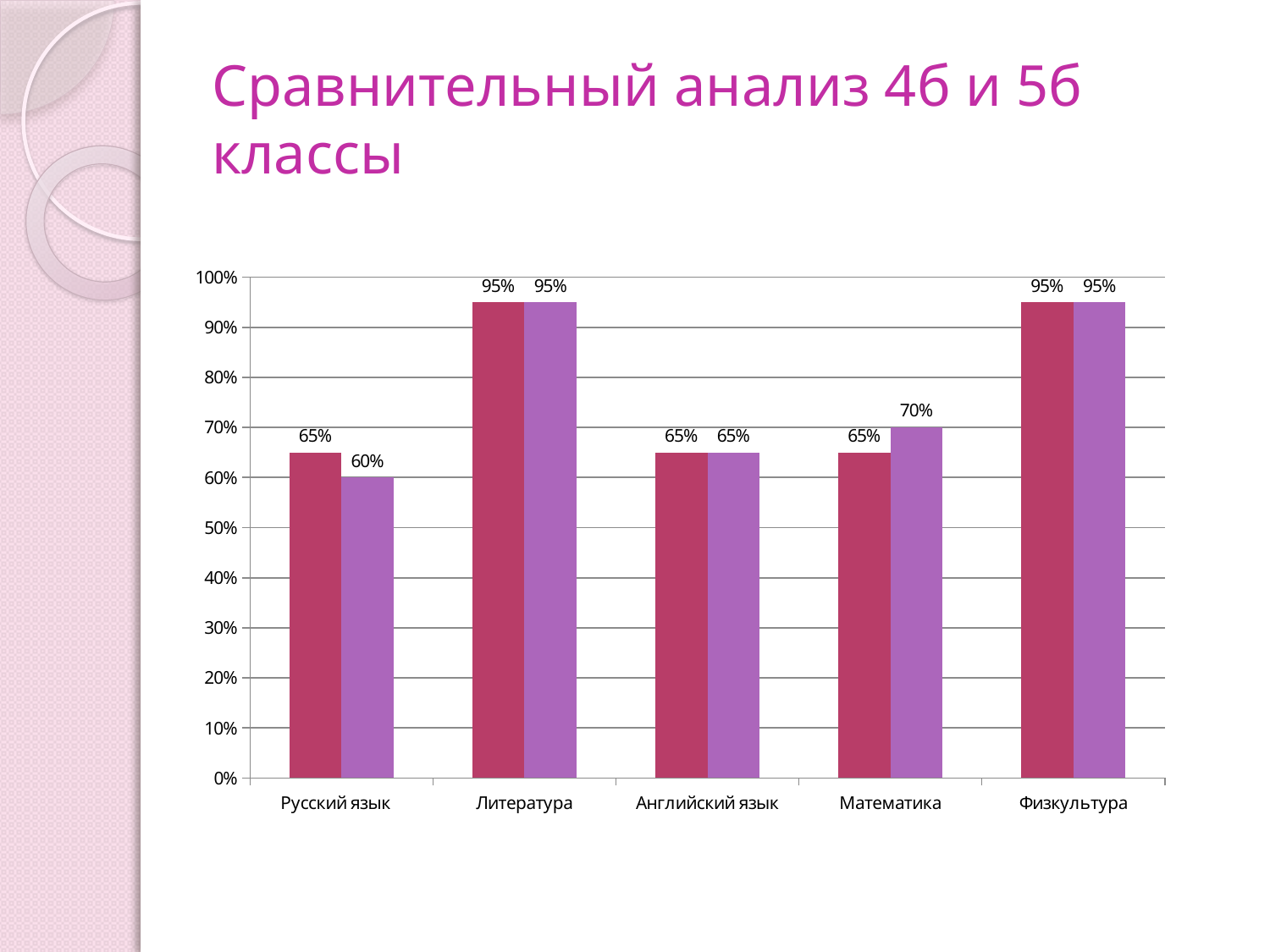
What is the title of the slide containing the chart? Сравнительный анализ 4б и 5б классы What kind of chart is shown on the slide? Bar chart What is the difference between the dark pink bar and the purple bar for Русский язык? 5% What is the value of the purple (right) bar for Математика? 70% What is the value of the dark pink (left) bar for Литература? 95% Among the purple (right) bars, which category has the lowest value? Русский язык What is the value of the purple (right) bar for Русский язык? 60% What is the value of the purple (right) bar for Английский язык? 65% Is the value of the purple bar for Физкультура greater or less than 90%? greater For Математика, which bar is larger, the dark pink (left) or the purple (right)? Purple (right) What is the value of the dark pink (left) bar for Русский язык? 65% How many categories are shown on the x axis? 5